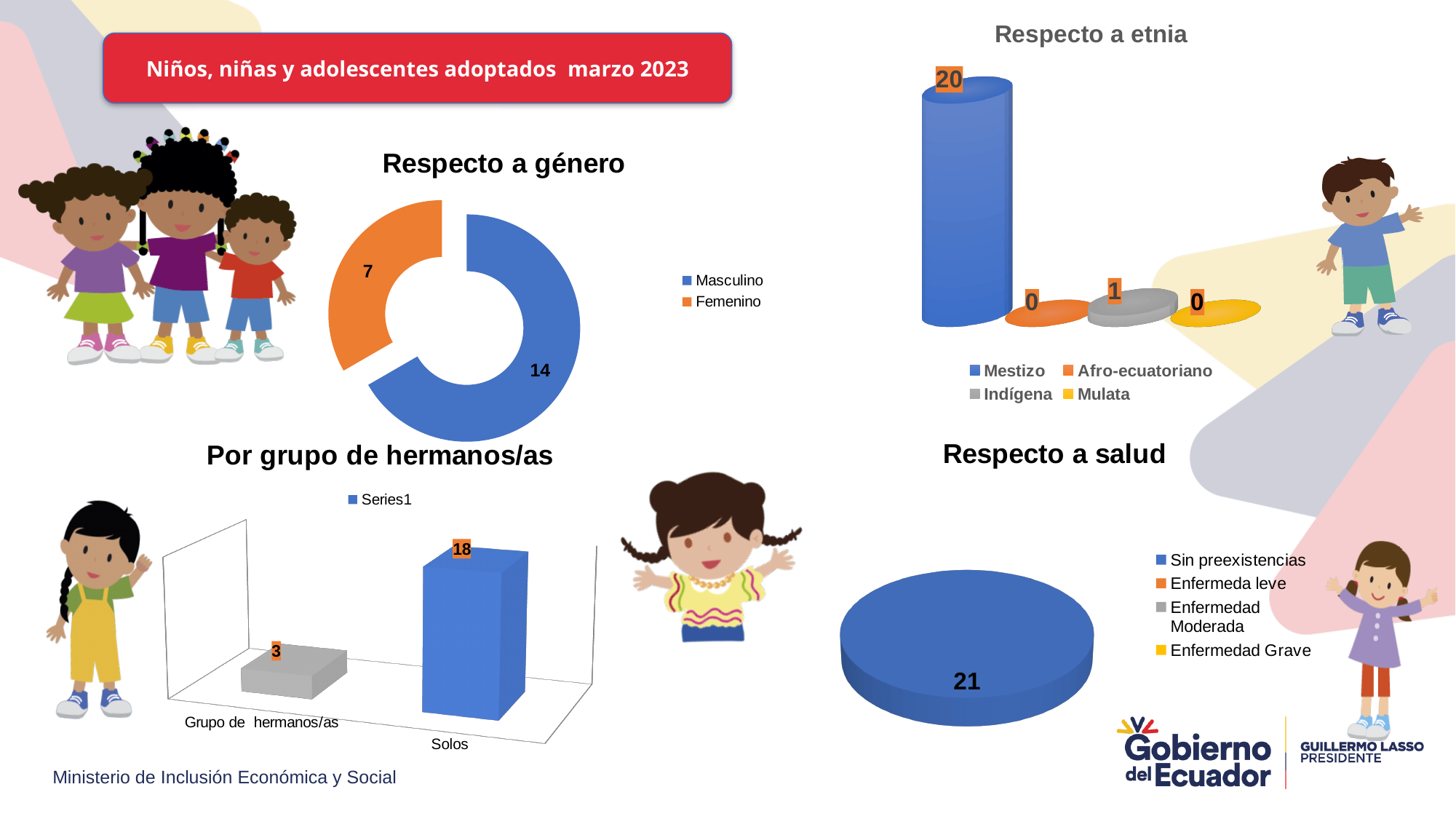
In the 'Respecto a género' chart, what is the difference between Masculino and Femenino? 7 In the 'Respecto a etnia' chart, what is the value for Mestizo? 20 In the 'Por grupo de hermanos/as' chart, what is the value for Grupo de hermanos/as? 3 What kind of chart is 'Respecto a género'? Doughnut chart In the 'Respecto a género' chart, what is the value for Femenino? 7 In the 'Respecto a etnia' chart, which category has the highest value? Mestizo In the 'Respecto a género' chart, what is the value for Masculino? 14 In the 'Respecto a salud' chart, what is the value for Sin preexistencias? 21 In the 'Por grupo de hermanos/as' chart, which is larger, Solos or Grupo de hermanos/as? Solos In the 'Por grupo de hermanos/as' chart, what is the value for Solos? 18 How many categories does the legend of the 'Respecto a etnia' chart list? 4 In the 'Respecto a etnia' chart, what is the value for Indígena? 1